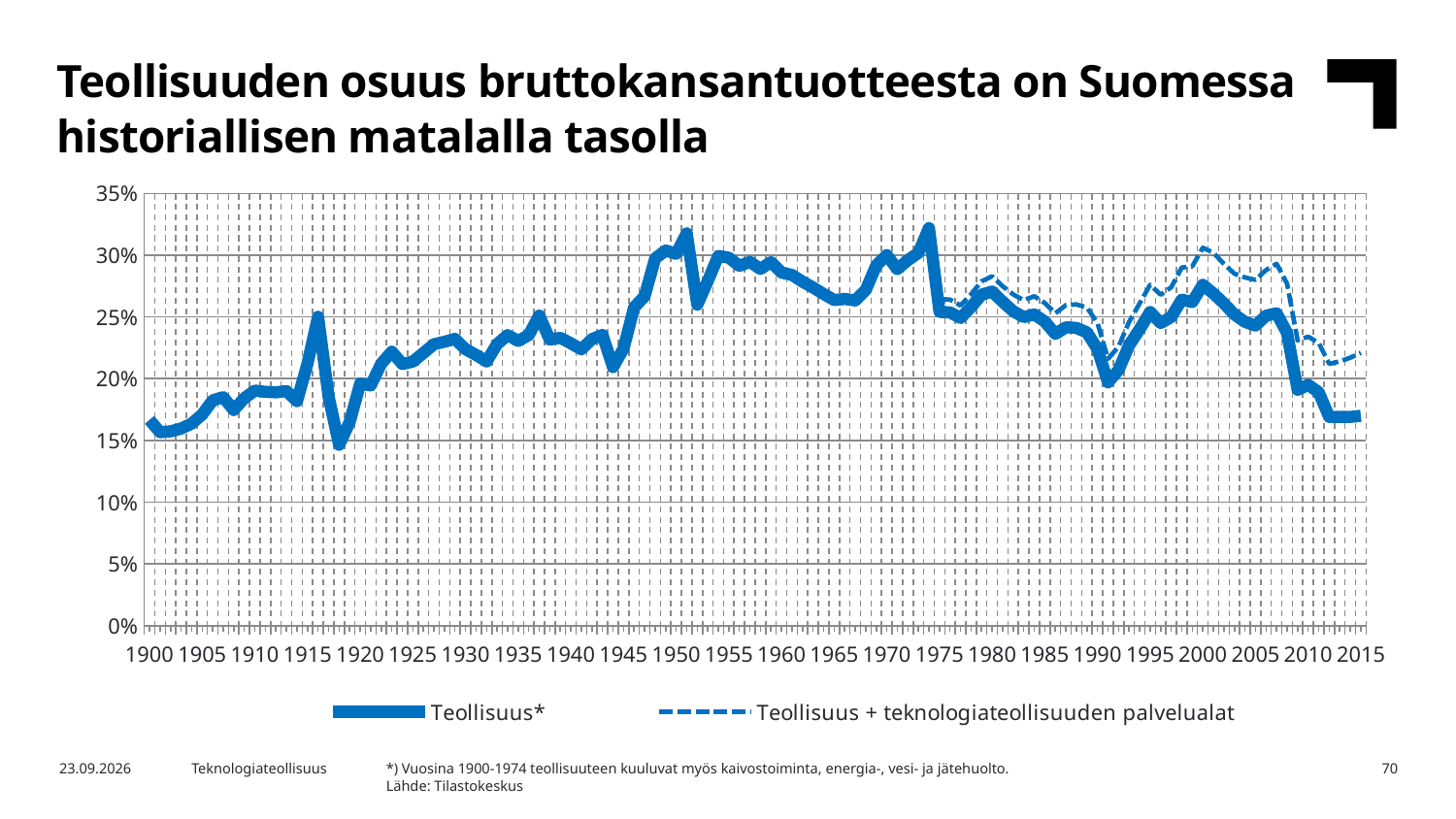
What kind of chart is shown on the slide? Line chart Is the value of Teollisuus* in 1975 greater or less than 30%? less Is the value of Teollisuus* in 1950 greater or less than 25%? greater Is the value of Teollisuus + teknologiateollisuuden palvelualat in 2000 greater or less than 25%? greater Does the Teollisuus* line rise or fall between 1945 and 1950? Rise What is the highest value shown on the vertical axis? 35% How many series does the legend list? 2 In 2005, which series has the higher value: Teollisuus* or Teollisuus + teknologiateollisuuden palvelualat? Teollisuus + teknologiateollisuuden palvelualat Does the Teollisuus* line rise or fall between 2008 and 2012? Fall Which series is drawn with a dashed line? Teollisuus + teknologiateollisuuden palvelualat